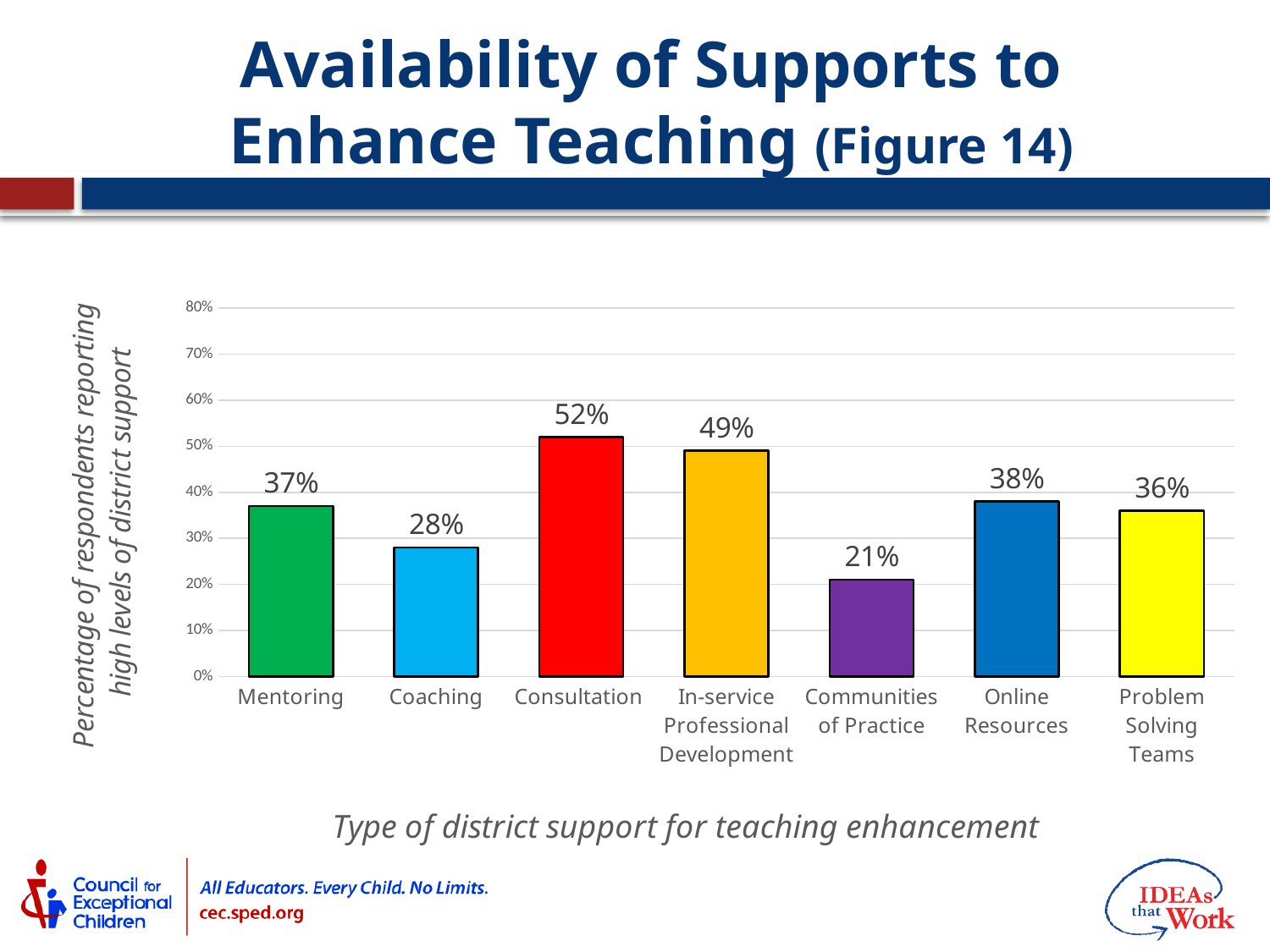
Which type of district support has the lowest percentage? Communities of Practice What is the label of the x axis? Type of district support for teaching enhancement Which has a higher percentage, Mentoring or In-service Professional Development? In-service Professional Development How many types of district support are shown on the chart? 7 What is the difference between the percentages for Consultation and Coaching? 24% What is the value shown for Communities of Practice? 21% Which type of district support has the highest percentage? Consultation What percentage of respondents reported high levels of district support for Consultation? 52% What kind of chart is shown on the slide? Bar chart Is the value for Problem Solving Teams greater or less than 40%? less What percentage is shown for Online Resources? 38% What colour is the bar for Consultation? Red